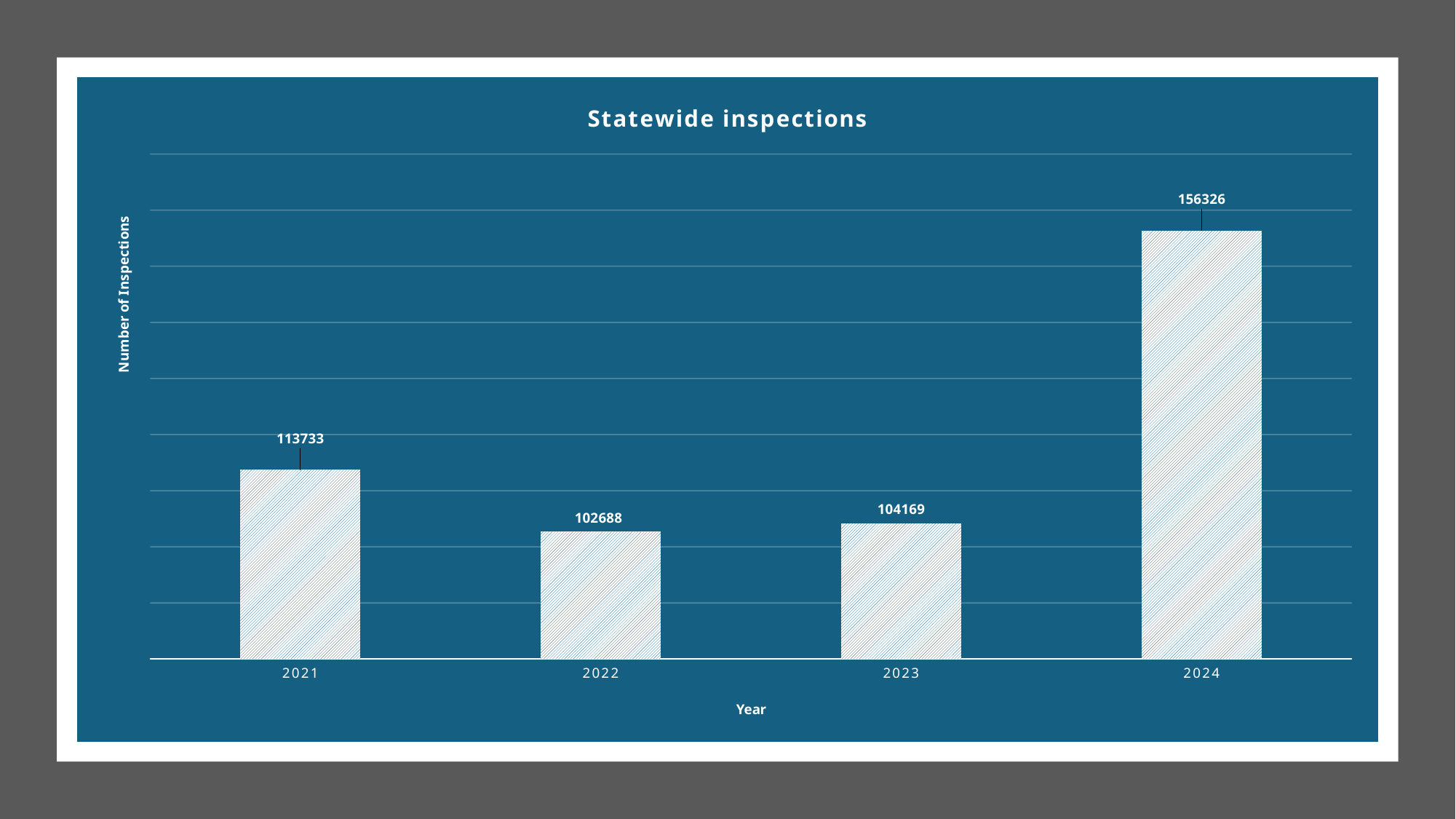
Which year has the highest number of inspections? 2024 What is the number of inspections for 2023? 104169 What is the difference in inspections between 2024 and 2021? 42593 What is the number of inspections for 2024? 156326 What kind of chart is shown on the slide? Bar chart What is the difference in inspections between 2023 and 2022? 1481 What is the title of the chart? Statewide inspections How many years are shown on the x axis? 4 What is the number of inspections for 2021? 113733 Which year had more inspections, 2021 or 2023? 2021 Which year has the lowest number of inspections? 2022 What is the number of inspections for 2022? 102688